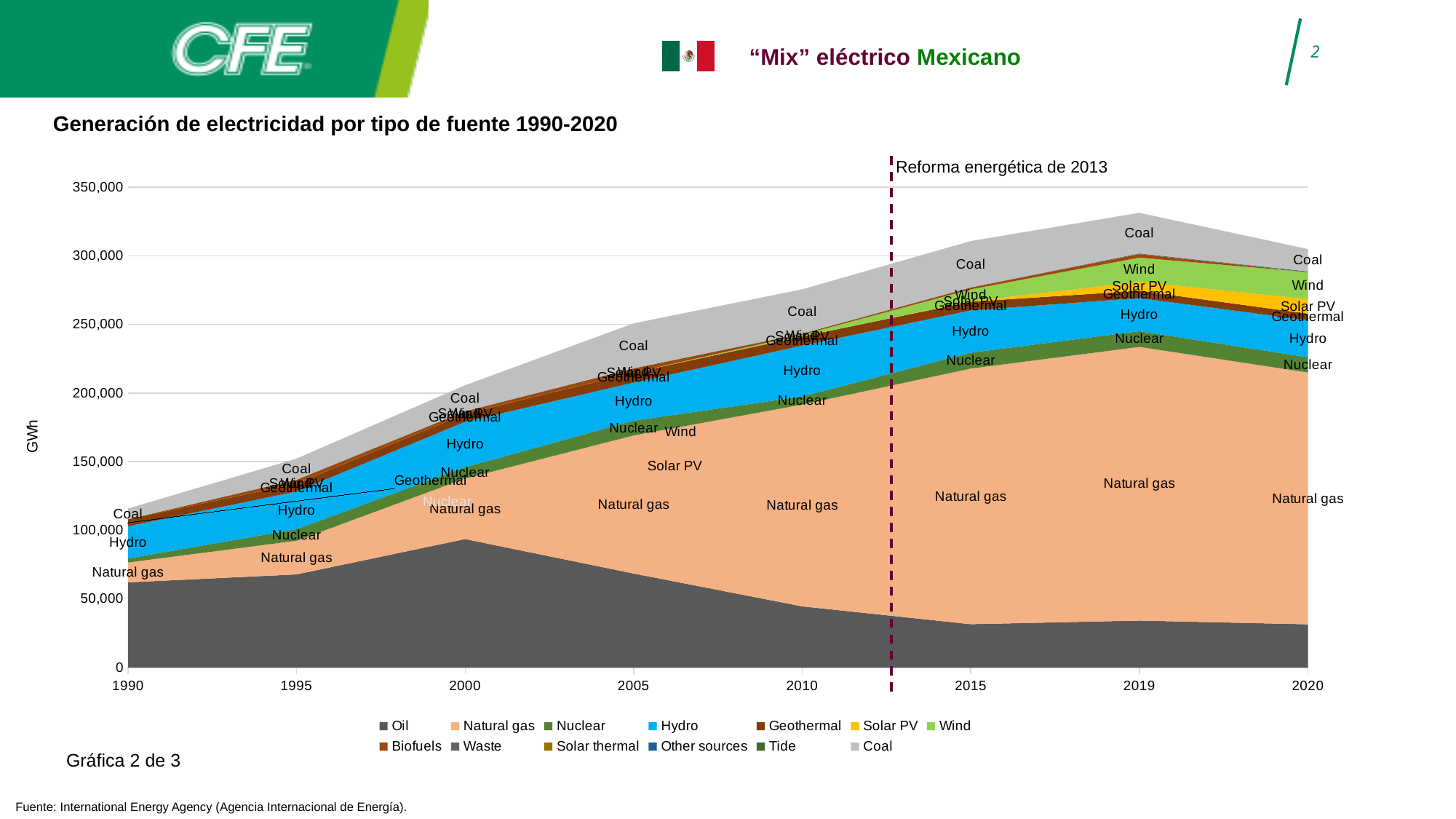
What kind of chart is shown on the slide? Stacked area chart What event does the dashed vertical line mark? Reforma energética de 2013 Is the Oil generation in 2000 greater or less than 50,000 GWh? greater What is the title of the chart? Generación de electricidad por tipo de fuente 1990-2020 Is the total generation in 2019 greater or less than 300,000 GWh? greater How many series does the legend list? 13 Which year has the larger total generation, 2019 or 2020? 2019 How many years are marked along the x axis? 8 Which year has the lowest total electricity generation? 1990 Is the Oil generation in 2020 greater or less than 50,000 GWh? less Which year has the highest total electricity generation? 2019